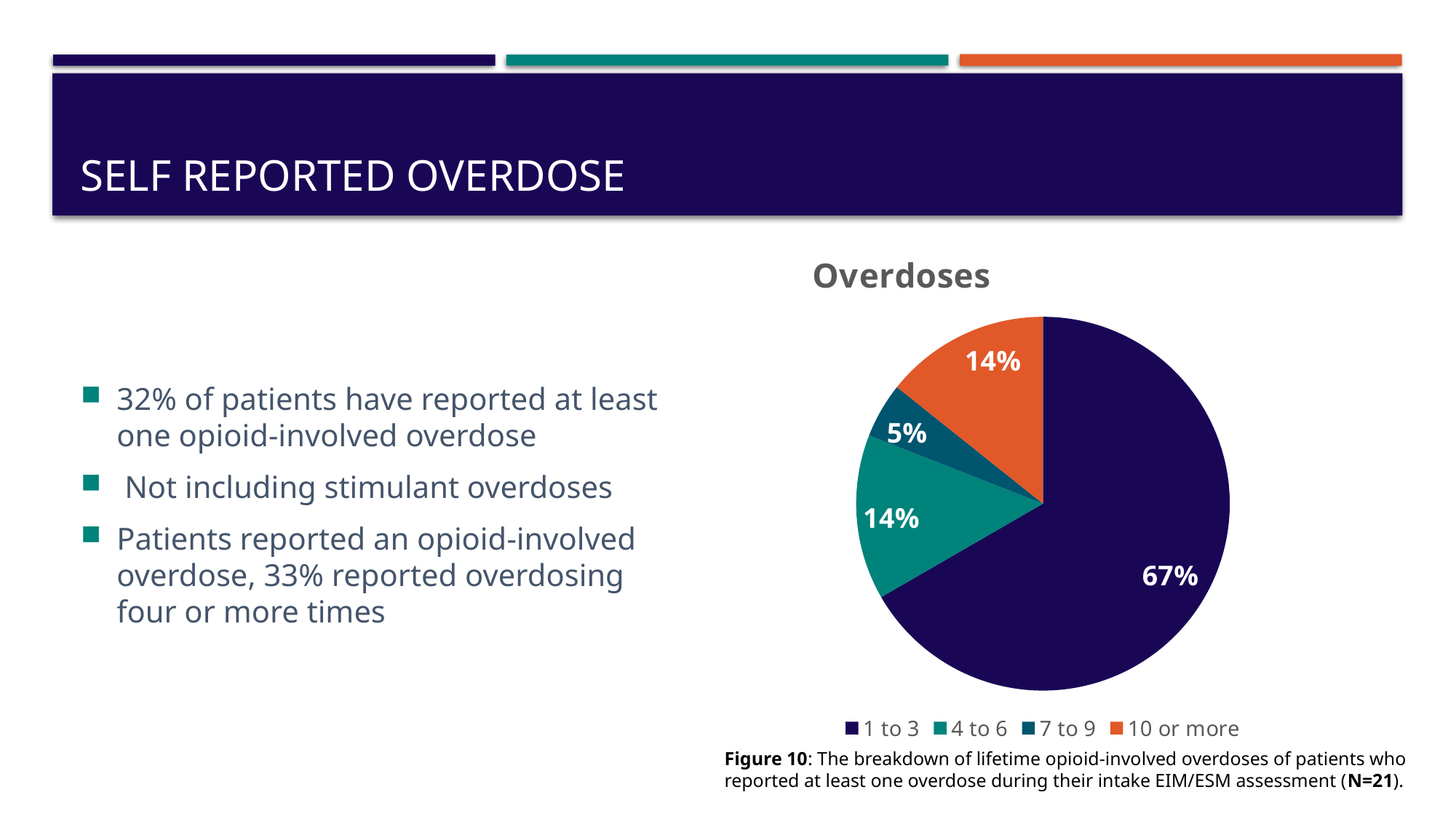
What share of the pie does the "1 to 3" slice represent? 67% How many categories does the pie chart show? 4 What is the difference in percentage points between the "1 to 3" slice and the "4 to 6" slice? 53 Which category has the smallest slice of the pie? 7 to 9 What share of the pie does the "10 or more" slice represent? 14% What type of chart is shown on the slide? pie chart Which is larger, the "4 to 6" slice or the "7 to 9" slice? 4 to 6 Which category is shown in orange in the legend? 10 or more What share of the pie does the "7 to 9" slice represent? 5% Which category has the largest slice of the pie? 1 to 3 What is the title of the chart? Overdoses